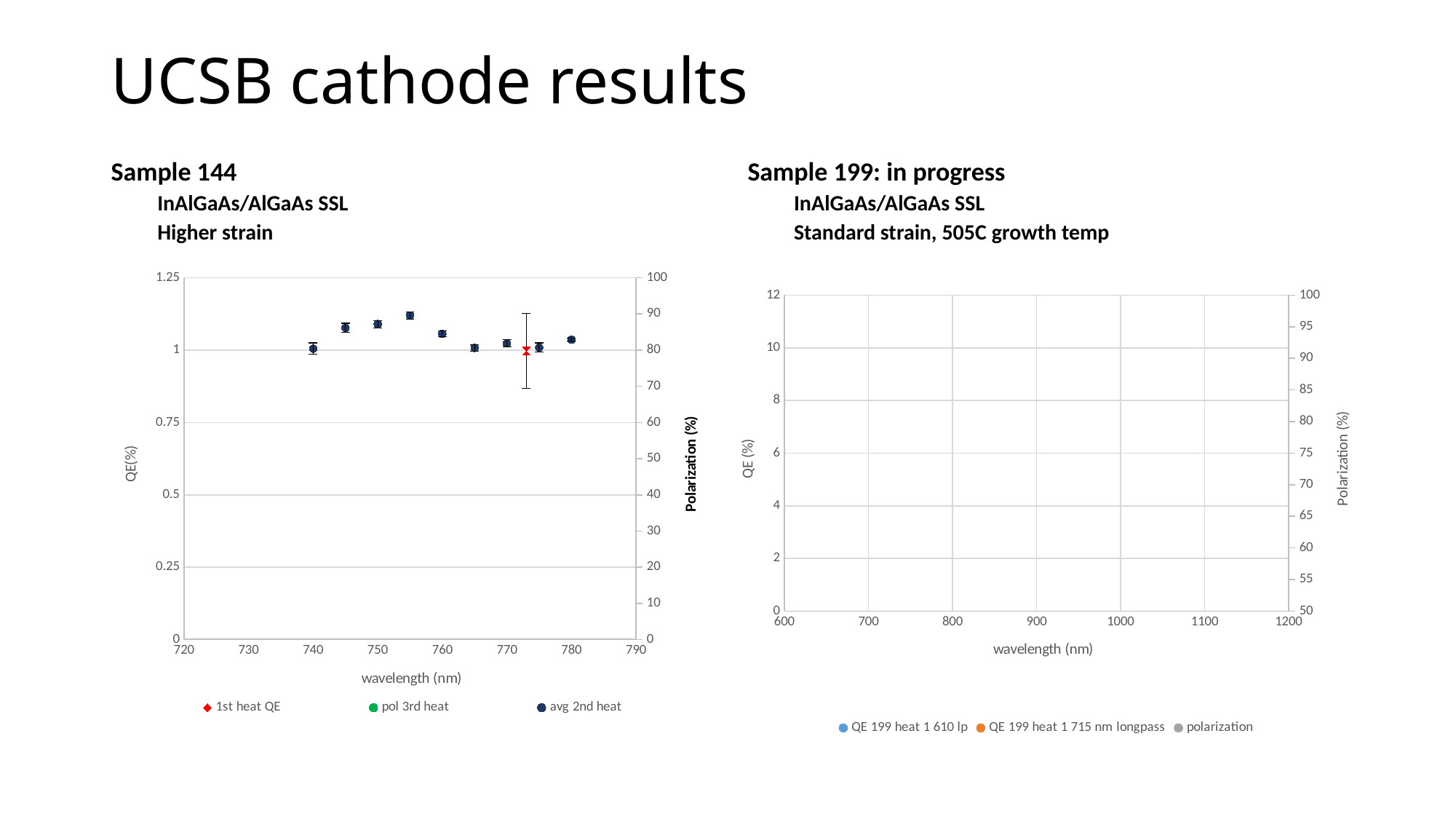
On the Sample 144 chart (left), at which wavelength is the avg 2nd heat QE highest? 755 nm On the Sample 144 chart (left), which has the larger avg 2nd heat QE: 755 nm or 765 nm? 755 nm On the Sample 144 chart (left), how many avg 2nd heat data points are plotted? 9 On the Sample 144 chart (left), is the avg 2nd heat QE at 755 nm greater or less than 1? greater On the Sample 199 chart (right), how many series does the legend list? 3 On the Sample 144 chart (left), which has the larger avg 2nd heat QE: 755 nm or 780 nm? 755 nm On the Sample 144 chart (left), how many series does the legend list? 3 On the Sample 199 chart (right), what is the label of the x axis? wavelength (nm) On the Sample 144 chart (left), what kind of chart is shown? scatter chart On the Sample 144 chart (left), do the avg 2nd heat QE values rise or fall from 740 nm to 755 nm? rise